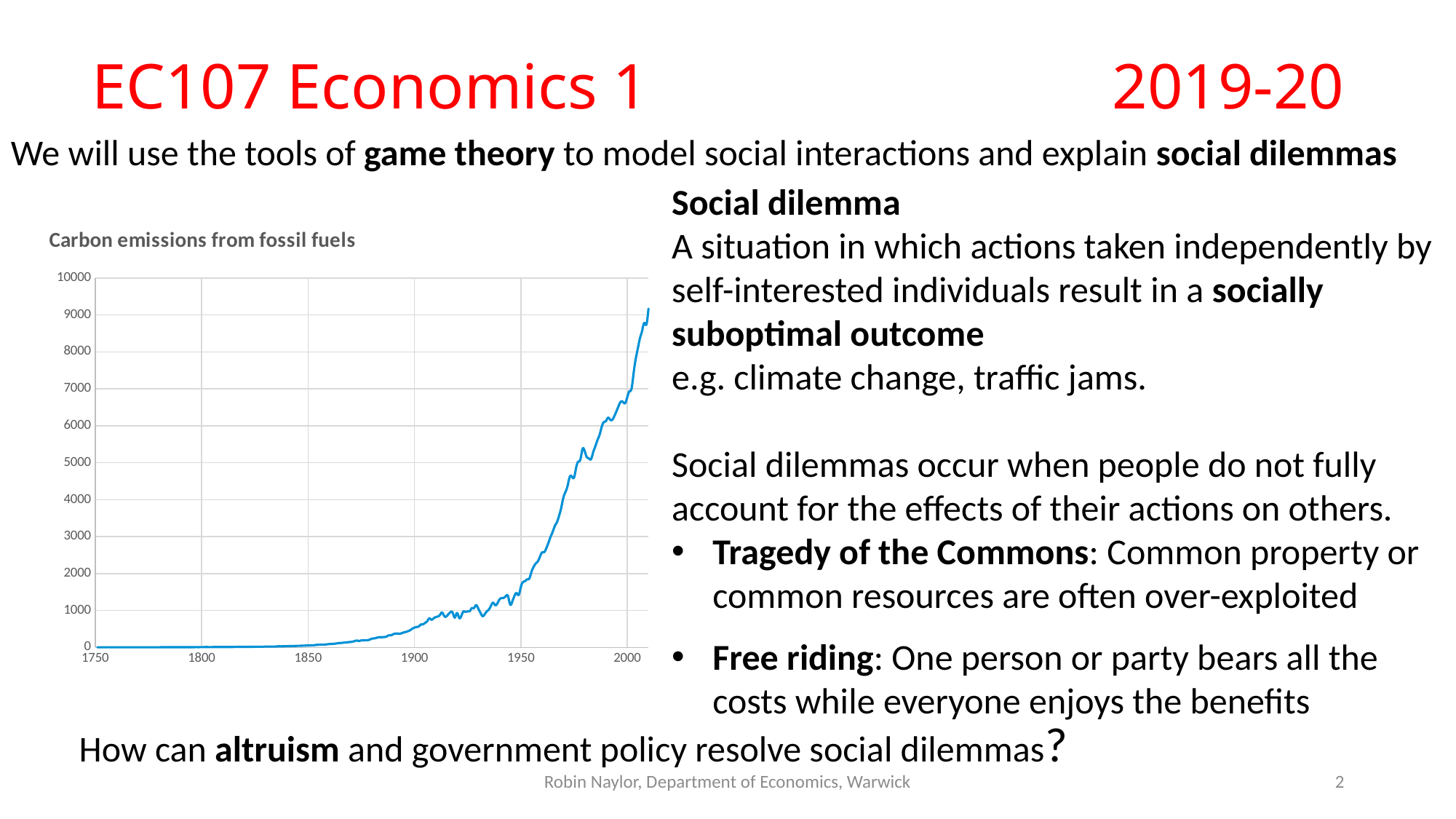
What kind of chart is shown on the slide? line chart Is the value for carbon emissions in 2000 greater or less than 6000? greater Is the value for carbon emissions in 1950 greater or less than 2000? less What is the highest value shown on the y axis of the chart? 10000 Is the value for carbon emissions in 1900 greater or less than 1000? less How many year labels are shown on the x axis of the chart? 6 What is the title of the chart on the slide? Carbon emissions from fossil fuels Do carbon emissions rise or fall over time along the x axis of the chart? rise Which year shown on the x axis has the higher carbon emissions, 1900 or 2000? 2000